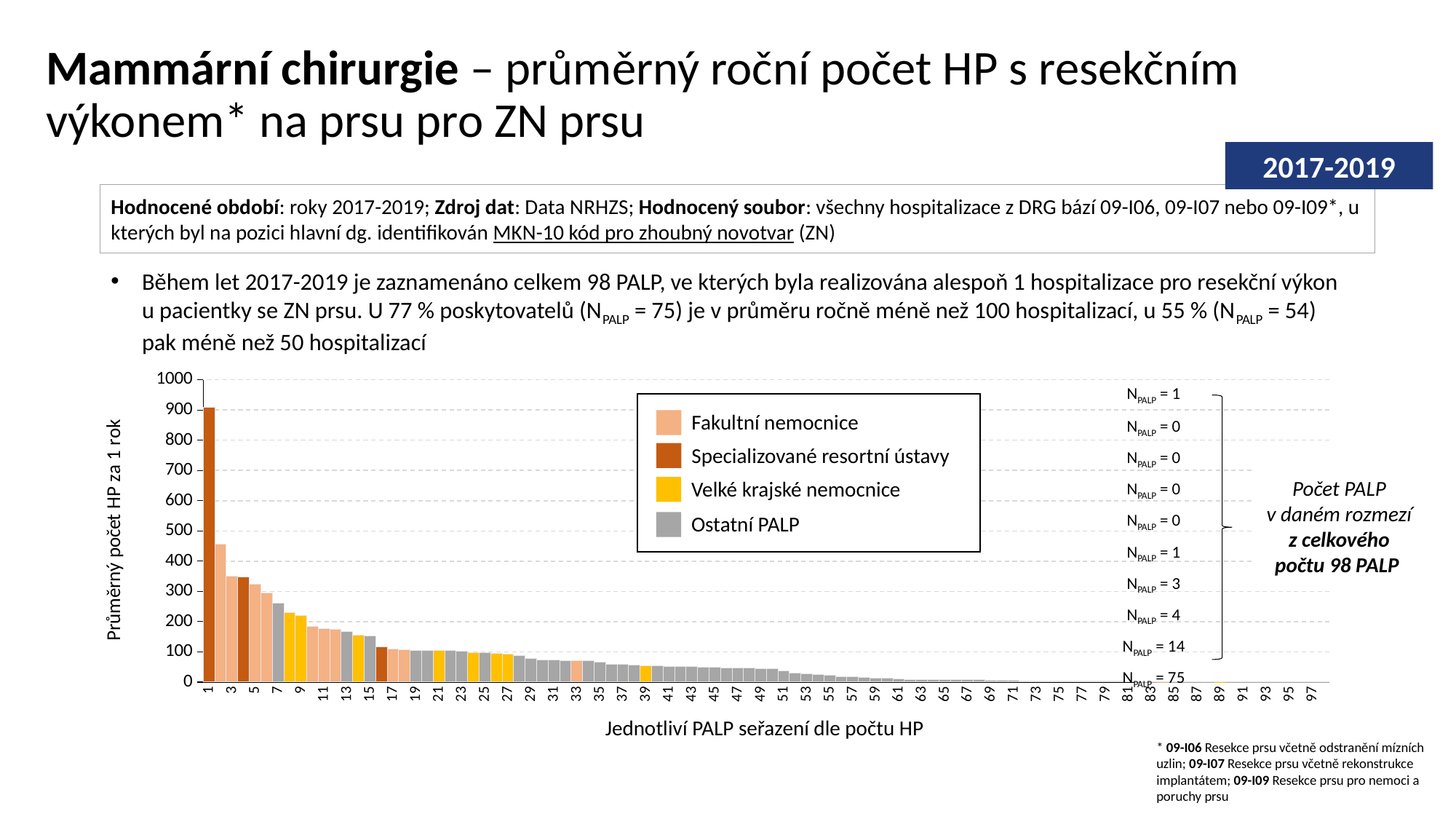
How many series does the chart legend list? 4 Is the value for PALP 3 greater or less than 300? greater According to the annotation on the right, how many PALP fall in the 100–200 range? N PALP = 14 Which legend category does the tallest bar (PALP 1) belong to? Specializované resortní ústavy Which of PALP 2 and PALP 7 has the larger value? PALP 2 Do the bar values rise or fall from left to right along the x axis? fall According to the annotation on the right, how many PALP fall in the lowest range (0–100 HP per year)? N PALP = 75 What kind of chart is shown on the slide? bar chart Is the value for PALP 2 greater or less than 400? greater Is the value for PALP 1 greater or less than 800? greater Which PALP (x-axis position) has the highest average annual number of HP? 1